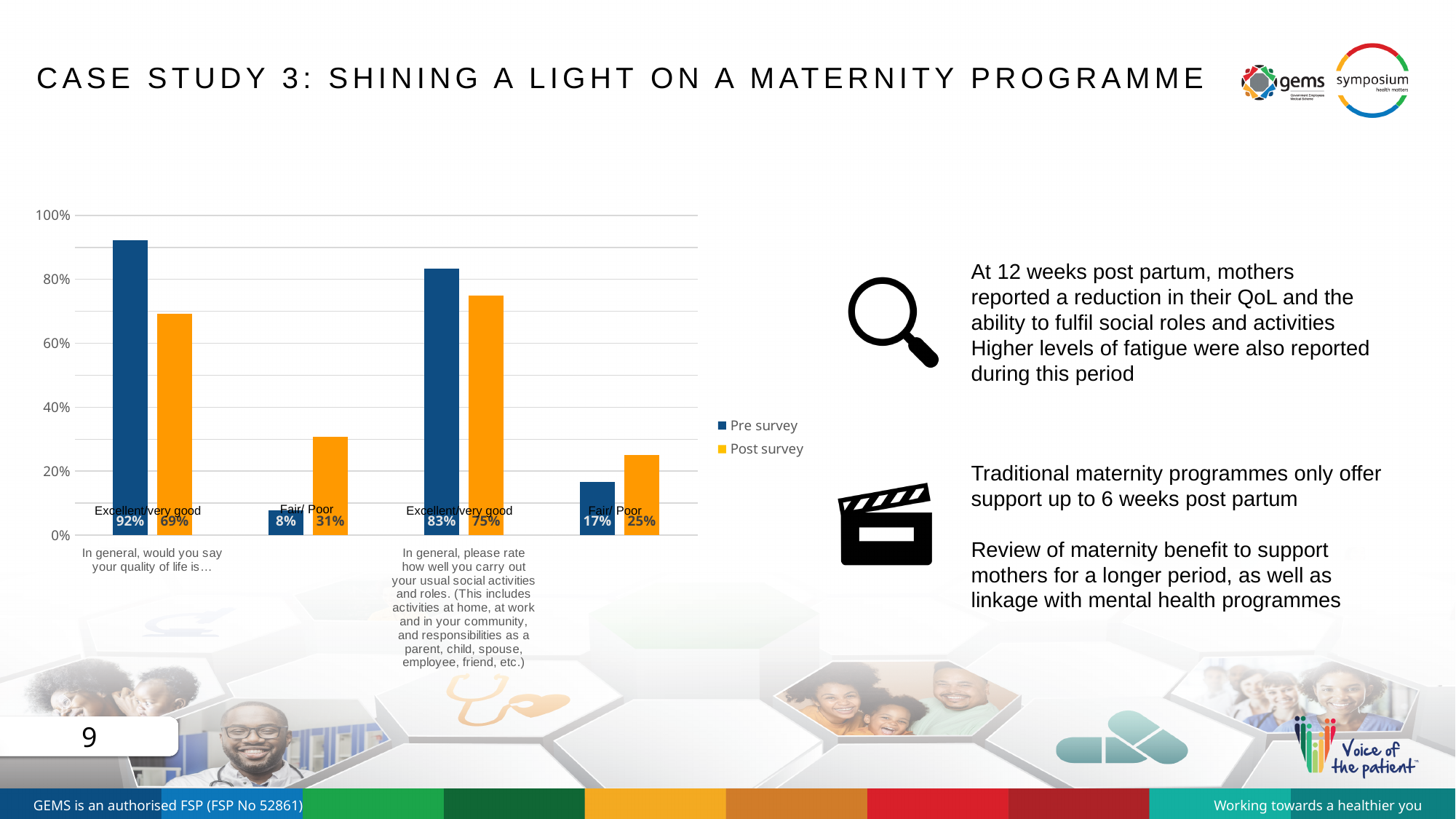
Which is larger for Fair/Poor under the social activities question: the Pre survey value or the Post survey value? Post survey What is the Post survey value for Excellent/very good under the question 'In general, would you say your quality of life is…'? 69% Which bar in the chart has the lowest value? Pre survey, Fair/Poor (quality of life) What is the Post survey value for Fair/Poor under the question 'In general, would you say your quality of life is…'? 31% What is the Pre survey value for Excellent/very good under the question 'In general, would you say your quality of life is…'? 92% What is the Pre survey value for Excellent/very good under the question about carrying out usual social activities and roles? 83% What is the difference between the Pre survey and Post survey values for Excellent/very good under the quality of life question? 23% Which bar in the chart has the highest value? Pre survey, Excellent/very good (quality of life) What kind of chart is shown on the slide? Bar chart What colour represents the Post survey series in the chart? Orange How many series does the legend list? 2 What is the Post survey value for Fair/Poor under the question about carrying out usual social activities and roles? 25%